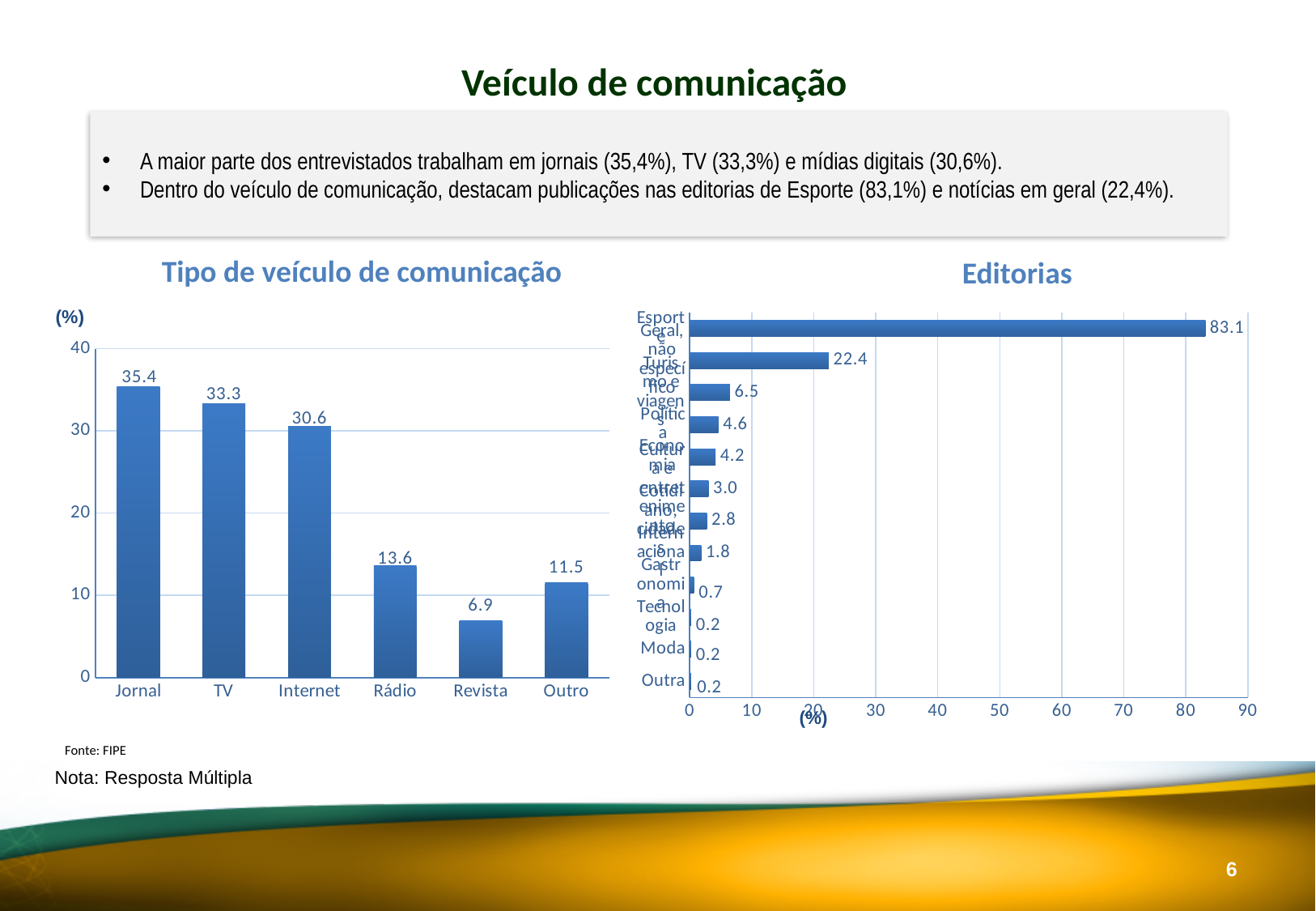
In the 'Editorias' chart, what is the value for Esporte? 83.1 In the 'Tipo de veículo de comunicação' chart, what is the difference between the values for Jornal and Internet? 4.8 In the 'Editorias' chart, which category has the highest value? Esporte In the 'Tipo de veículo de comunicação' chart, which category has the lowest value? Revista In the 'Tipo de veículo de comunicação' chart, what is the value for Jornal? 35.4 What kind of chart is the 'Tipo de veículo de comunicação' chart? Bar chart In the 'Tipo de veículo de comunicação' chart, what is the value for Rádio? 13.6 In the 'Tipo de veículo de comunicação' chart, which is larger, the value for Outro or the value for Revista? Outro In the 'Editorias' chart, what is the value for Moda? 0.2 In the 'Editorias' chart, what is the difference between the values for Esporte and Gastronomia? 82.4 In the 'Tipo de veículo de comunicação' chart, which category has the highest value? Jornal How many categories are shown in the 'Tipo de veículo de comunicação' chart? 6